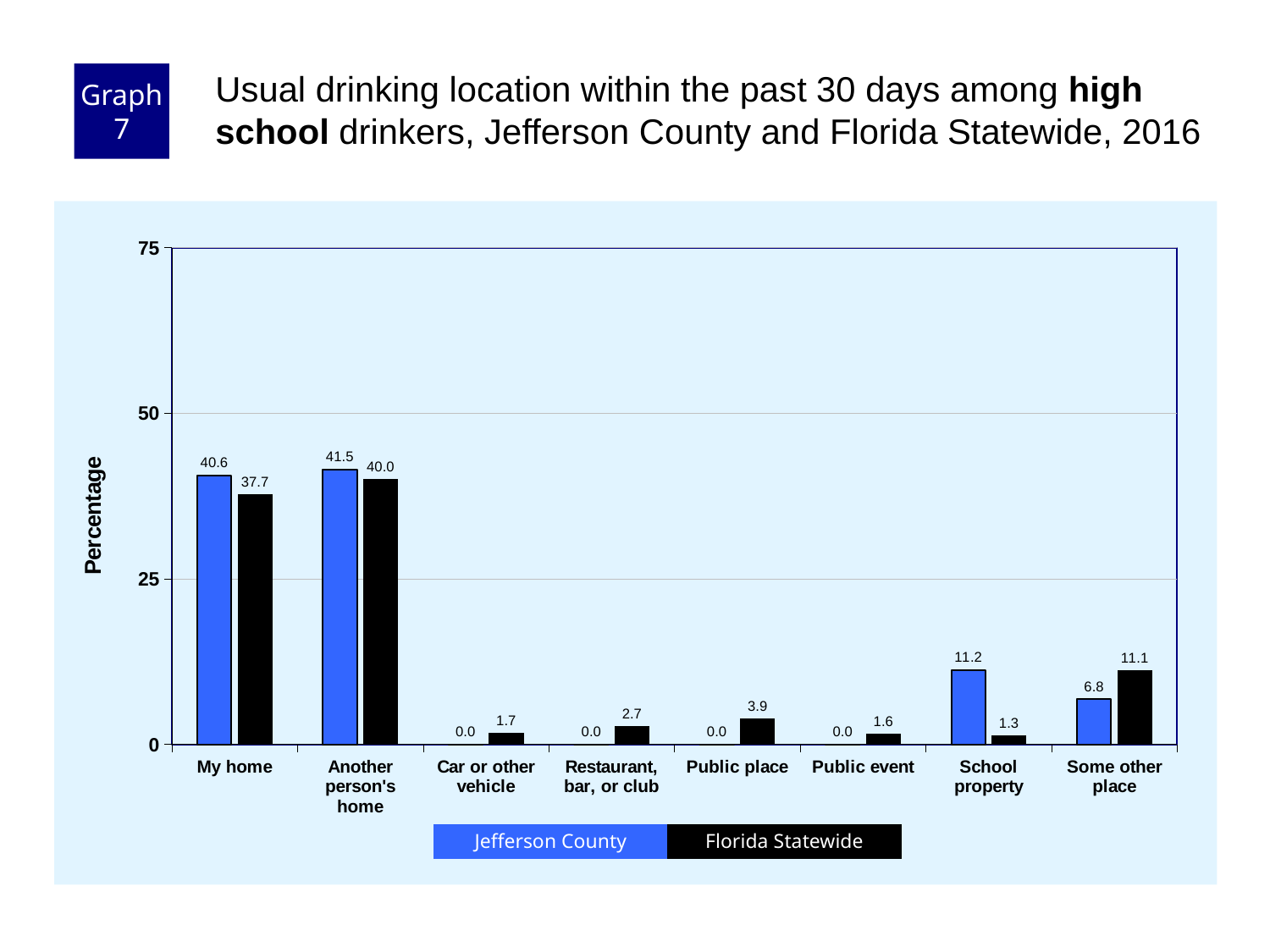
What is the Florida Statewide value for Public place? 3.9 What kind of chart is shown on the slide? bar chart Which is larger for School property, Jefferson County or Florida Statewide? Jefferson County How many categories are shown on the x axis? 8 How many series does the legend list? 2 What is the Florida Statewide value for Some other place? 11.1 What is the Jefferson County value for My home? 40.6 Which category has the highest Jefferson County value? Another person's home Which category has the lowest Florida Statewide value? School property Is the Florida Statewide value for Another person's home greater or less than 25? greater What is the label of the y axis? Percentage What is the difference between the Jefferson County and Florida Statewide values for My home? 2.9